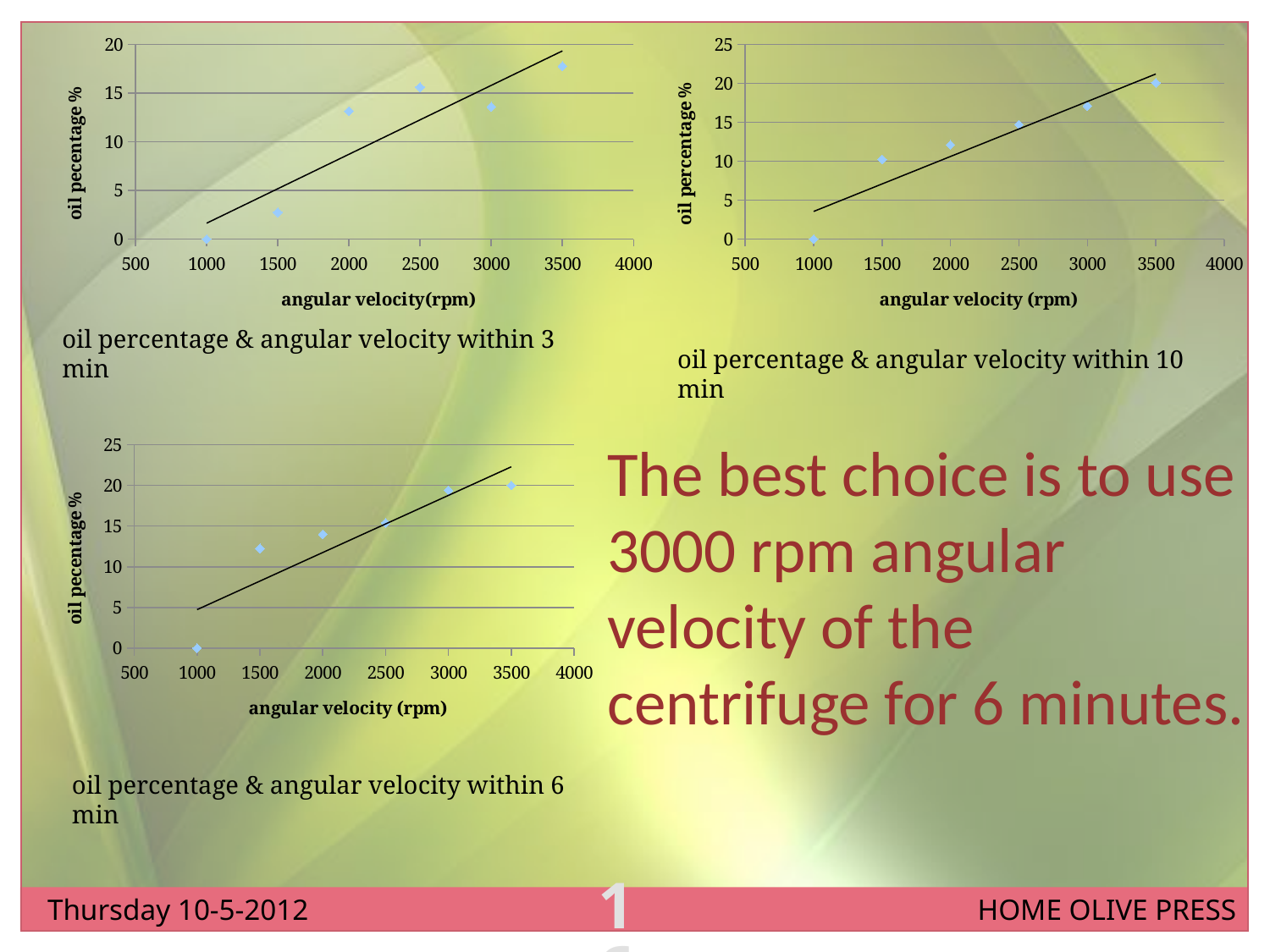
In the 'oil percentage & angular velocity within 3 min' chart, what is the oil percentage at 1000 rpm? 0 In the 'oil percentage & angular velocity within 3 min' chart, how many data points are plotted? 6 In the 'oil percentage & angular velocity within 10 min' chart, do the oil percentage values rise or fall as angular velocity increases? rise What is the x-axis label of the 'oil percentage & angular velocity within 6 min' chart? angular velocity (rpm) What kind of chart is the 'oil percentage & angular velocity within 3 min' chart? scatter chart In the 'oil percentage & angular velocity within 6 min' chart, is the oil percentage at 3000 rpm greater or less than 15? greater In the 'oil percentage & angular velocity within 6 min' chart, at which angular velocity is the oil percentage lowest? 1000 In the 'oil percentage & angular velocity within 10 min' chart, is the oil percentage at 1500 rpm greater or less than 5? greater In the 'oil percentage & angular velocity within 3 min' chart, at which angular velocity is the oil percentage highest? 3500 In the 'oil percentage & angular velocity within 3 min' chart, is the oil percentage at 1500 rpm greater or less than 5? less In the 'oil percentage & angular velocity within 3 min' chart, which has the higher oil percentage, 2500 rpm or 3000 rpm? 2500 rpm